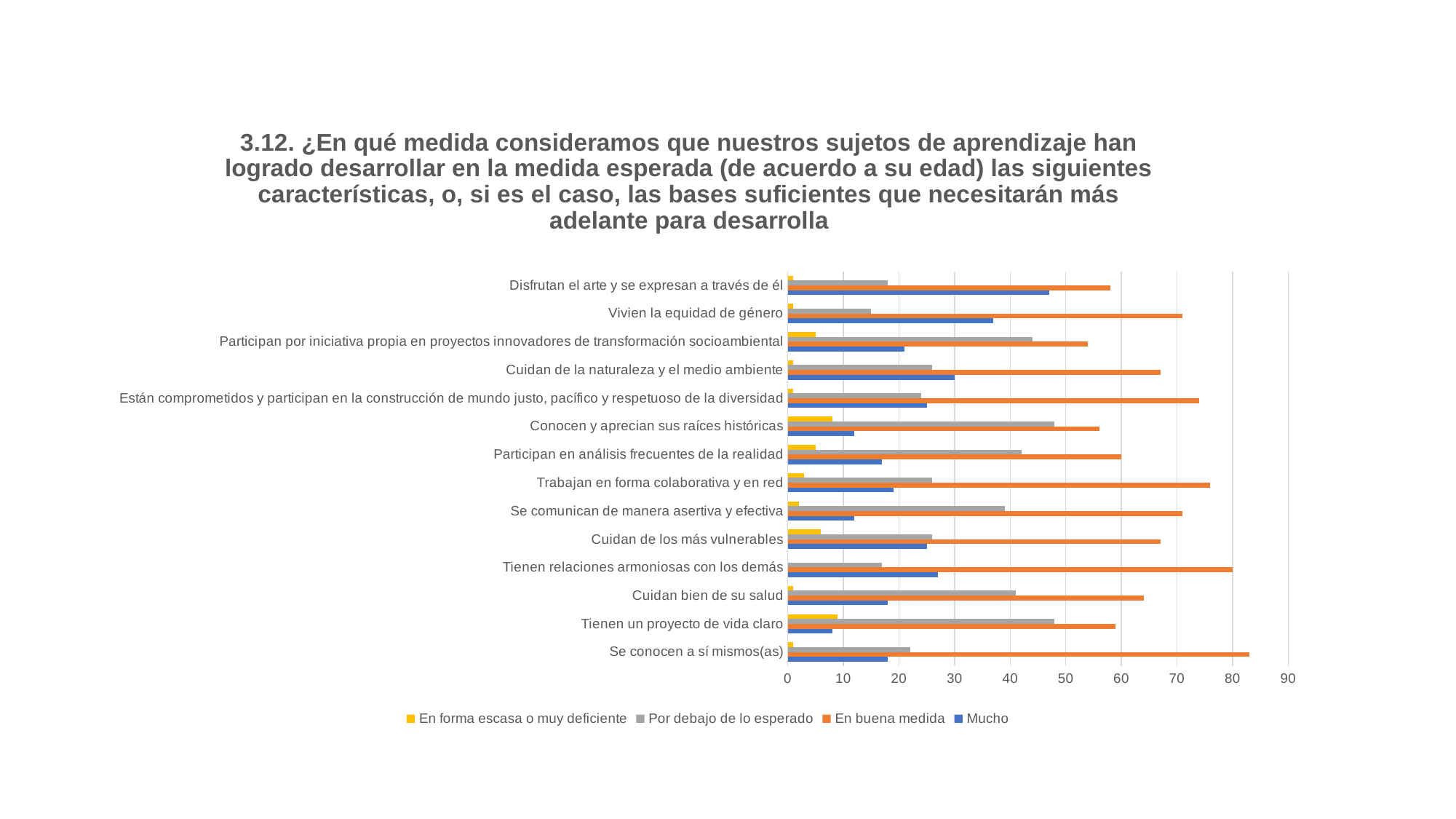
Is the value of "Mucho" for "Vivien la equidad de género" greater or less than 30? greater Which colour represents the series "Mucho" in the legend? blue For the series "Mucho", which is larger: "Disfrutan el arte y se expresan a través de él" or "Vivien la equidad de género"? Disfrutan el arte y se expresan a través de él Which category has the highest value for the series "Mucho"? Disfrutan el arte y se expresan a través de él Which category has the lowest value for the series "En buena medida"? Participan por iniciativa propia en proyectos innovadores de transformación socioambiental How many series does the legend list? 4 Which category has the highest value for the series "En buena medida"? Se conocen a sí mismos(as) Which category has the lowest value for the series "Mucho"? Tienen un proyecto de vida claro How many categories (characteristics) are plotted on the chart? 14 What kind of chart is shown on the slide? bar chart Is the value of "Mucho" for "Disfrutan el arte y se expresan a través de él" greater or less than 40? greater Is the value of "En buena medida" for "Se conocen a sí mismos(as)" greater or less than 80? greater